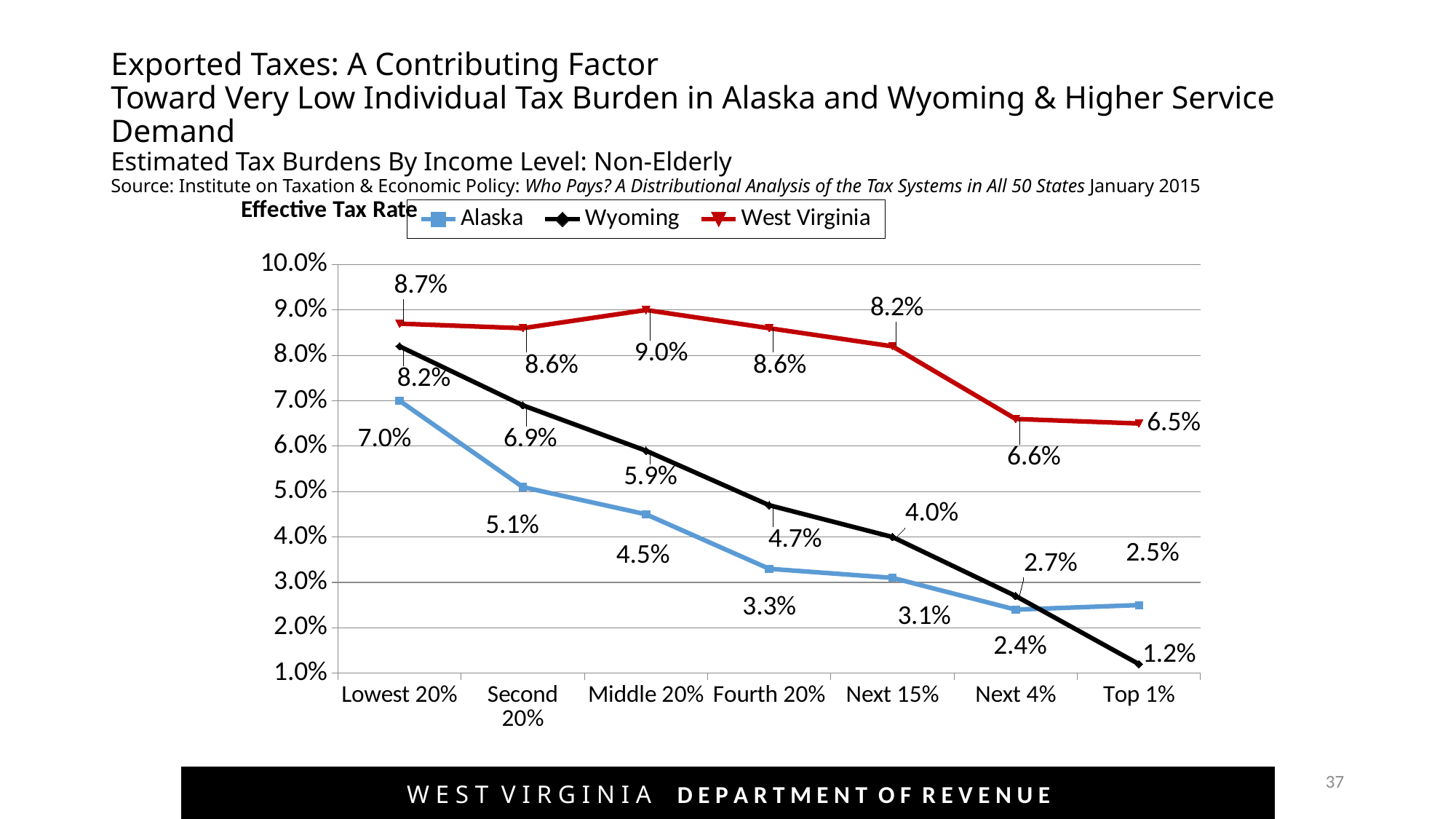
Does the Wyoming effective tax rate rise or fall from the Lowest 20% to the Top 1% income level? Fall What is the effective tax rate for Alaska at the Lowest 20% income level? 7.0% What kind of chart is shown on the slide? Line chart Which has a higher effective tax rate at the Top 1% income level, Alaska or Wyoming? Alaska At which income level is the West Virginia effective tax rate highest? Middle 20% What is the effective tax rate for Wyoming at the Top 1% income level? 1.2% How many income levels are shown on the x axis? 7 What is the difference between the West Virginia and Wyoming effective tax rates at the Top 1% income level? 5.3% How many series does the legend list? 3 What is the effective tax rate for West Virginia at the Middle 20% income level? 9.0% Which series is drawn in red in the chart? West Virginia At which income level is the Alaska effective tax rate lowest? Next 4%